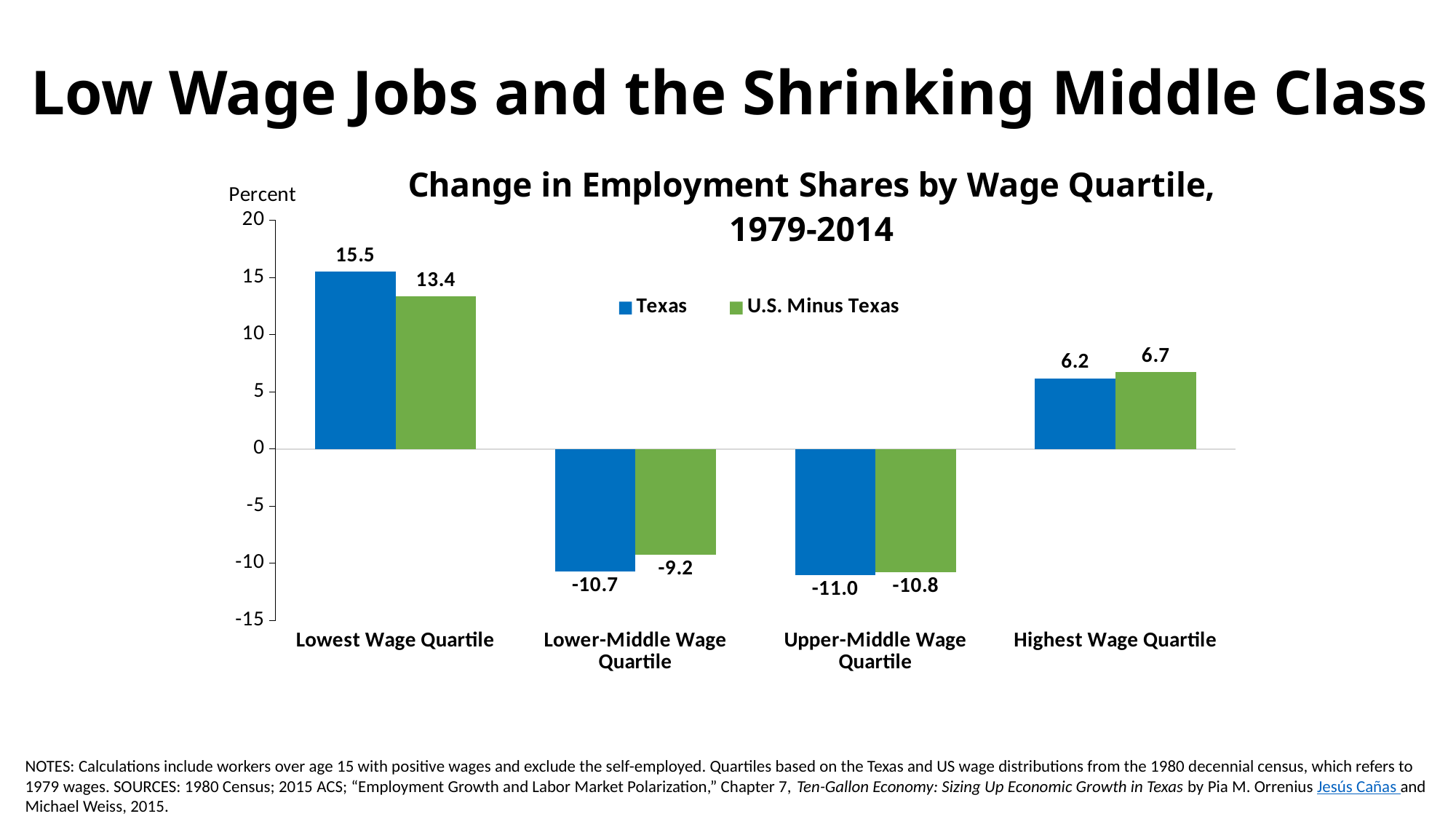
What is the value for U.S. Minus Texas in the Upper-Middle Wage Quartile? -10.8 What is the difference between the Texas and U.S. Minus Texas values in the Lowest Wage Quartile? 2.1 Which wage quartile has the highest value for U.S. Minus Texas? Lowest Wage Quartile Is the value for U.S. Minus Texas in the Lowest Wage Quartile greater or less than 10? greater How many wage quartile categories are shown on the x axis? 4 What is the value for Texas in the Lowest Wage Quartile? 15.5 What is the title of the chart? Change in Employment Shares by Wage Quartile, 1979-2014 What kind of chart is shown on the slide? Bar chart How many series does the legend list? 2 Which is larger in the Lower-Middle Wage Quartile, the Texas value or the U.S. Minus Texas value? U.S. Minus Texas What is the value for Texas in the Highest Wage Quartile? 6.2 Which wage quartile has the lowest value for Texas? Upper-Middle Wage Quartile